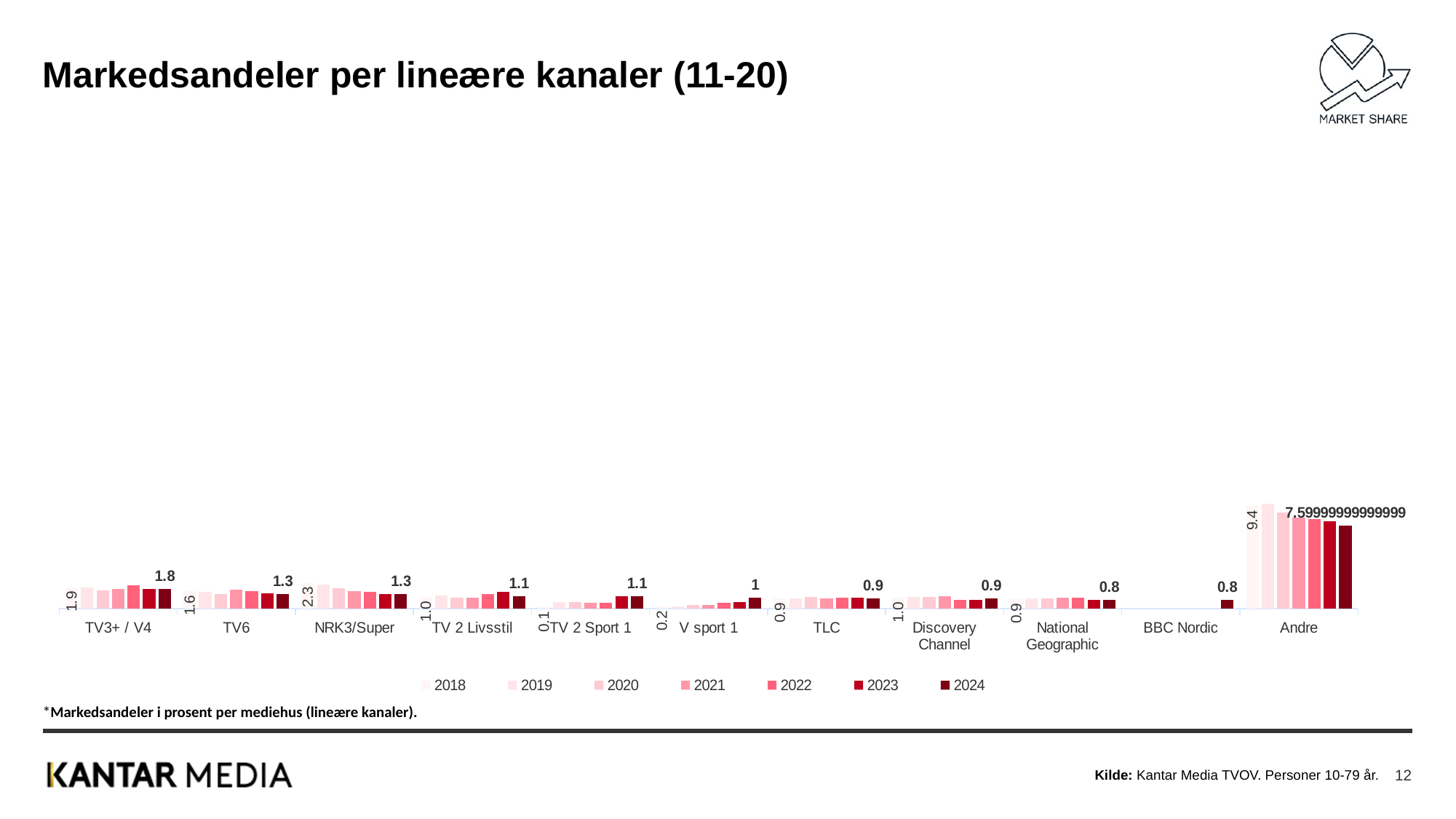
Which category has the highest 2024 value? Andre Do the values for TV 2 Sport 1 rise or fall from 2018 to 2024? rise How many categories are shown on the x axis? 11 What is the difference between the 2018 and 2024 values for NRK3/Super? 1.0 What is the 2018 value for Andre? 9.4 What is the 2024 value for TV3+ / V4? 1.8 What is the 2018 value for NRK3/Super? 2.3 What kind of chart is shown on the slide? bar chart Which category has the lowest 2018 value among those labelled? TV 2 Sport 1 What is the 2024 value for National Geographic? 0.8 Which is larger, the 2024 value for TV6 or the 2024 value for TLC? TV6 How many series does the legend list? 7